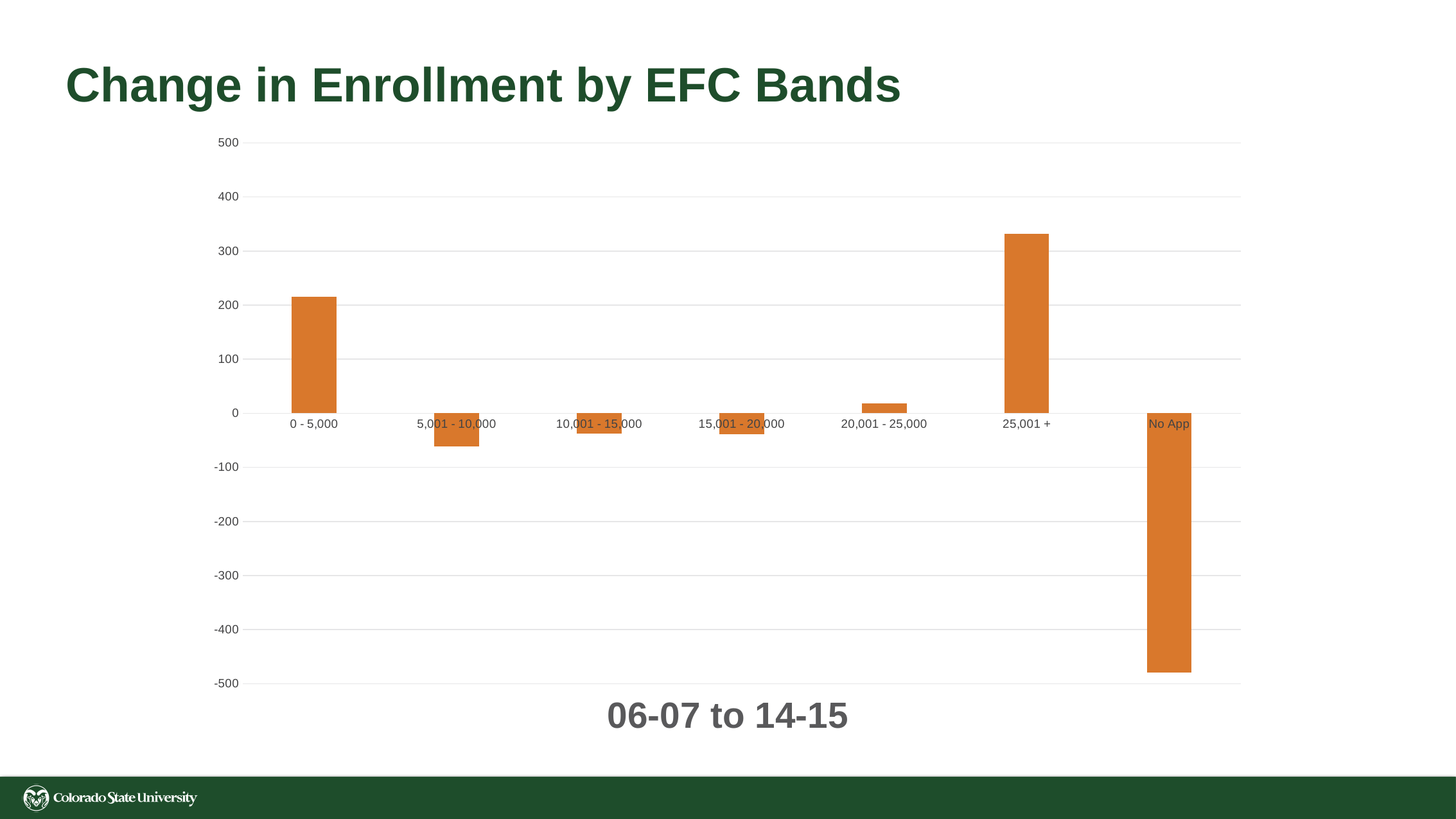
Is the value for 25,001 + greater or less than 300? greater How many EFC band categories are plotted on the chart? 7 Which category has the highest change in enrollment? 25,001 + What is the title of the chart? Change in Enrollment by EFC Bands Is the value for 5,001 - 10,000 greater or less than 0? less Which is larger, the value for 0 - 5,000 or the value for 25,001 +? 25,001 + Is the value for 0 - 5,000 greater or less than 200? greater Which category has the lowest change in enrollment? No App What kind of chart is shown on the slide? bar chart Which is larger, the value for 20,001 - 25,000 or the value for 5,001 - 10,000? 20,001 - 25,000